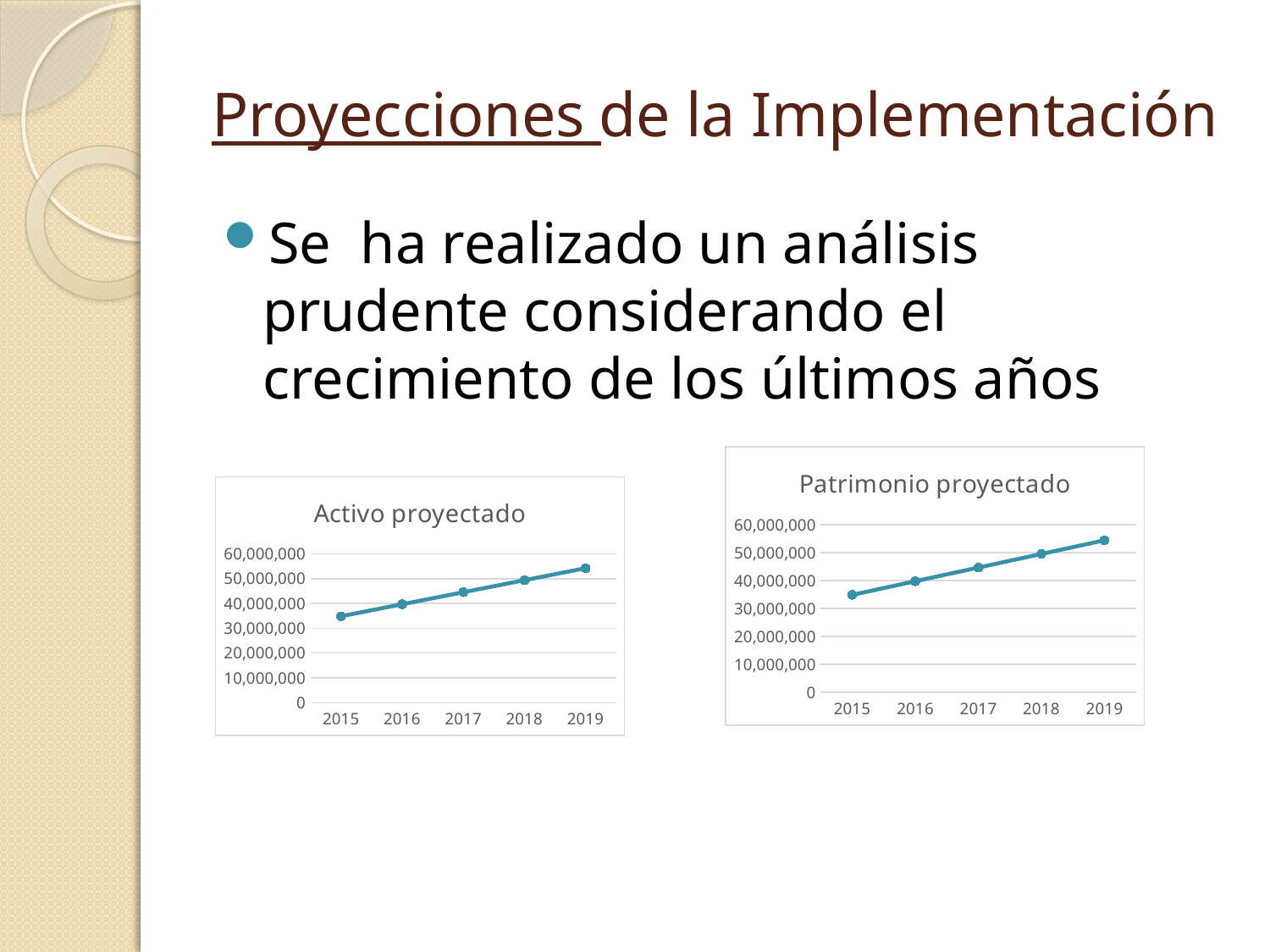
In the 'Activo proyectado' chart, which year has the highest value? 2019 In the 'Patrimonio proyectado' chart, is the value for 2019 greater or less than 50,000,000? greater What is the title of the chart on the right side of the slide? Patrimonio proyectado In the 'Activo proyectado' chart, is the value for 2015 greater or less than 40,000,000? less What kind of chart is the 'Patrimonio proyectado' chart? line chart How many years are plotted on the x axis of the 'Activo proyectado' chart? 5 What kind of chart is the 'Activo proyectado' chart? line chart How many data points does the 'Patrimonio proyectado' chart show? 5 In the 'Patrimonio proyectado' chart, do the values rise or fall from 2015 to 2019? rise In the 'Activo proyectado' chart, which is larger, the value for 2017 or the value for 2019? 2019 In the 'Activo proyectado' chart, do the values rise or fall from 2015 to 2019? rise In the 'Patrimonio proyectado' chart, which year has the lowest value? 2015